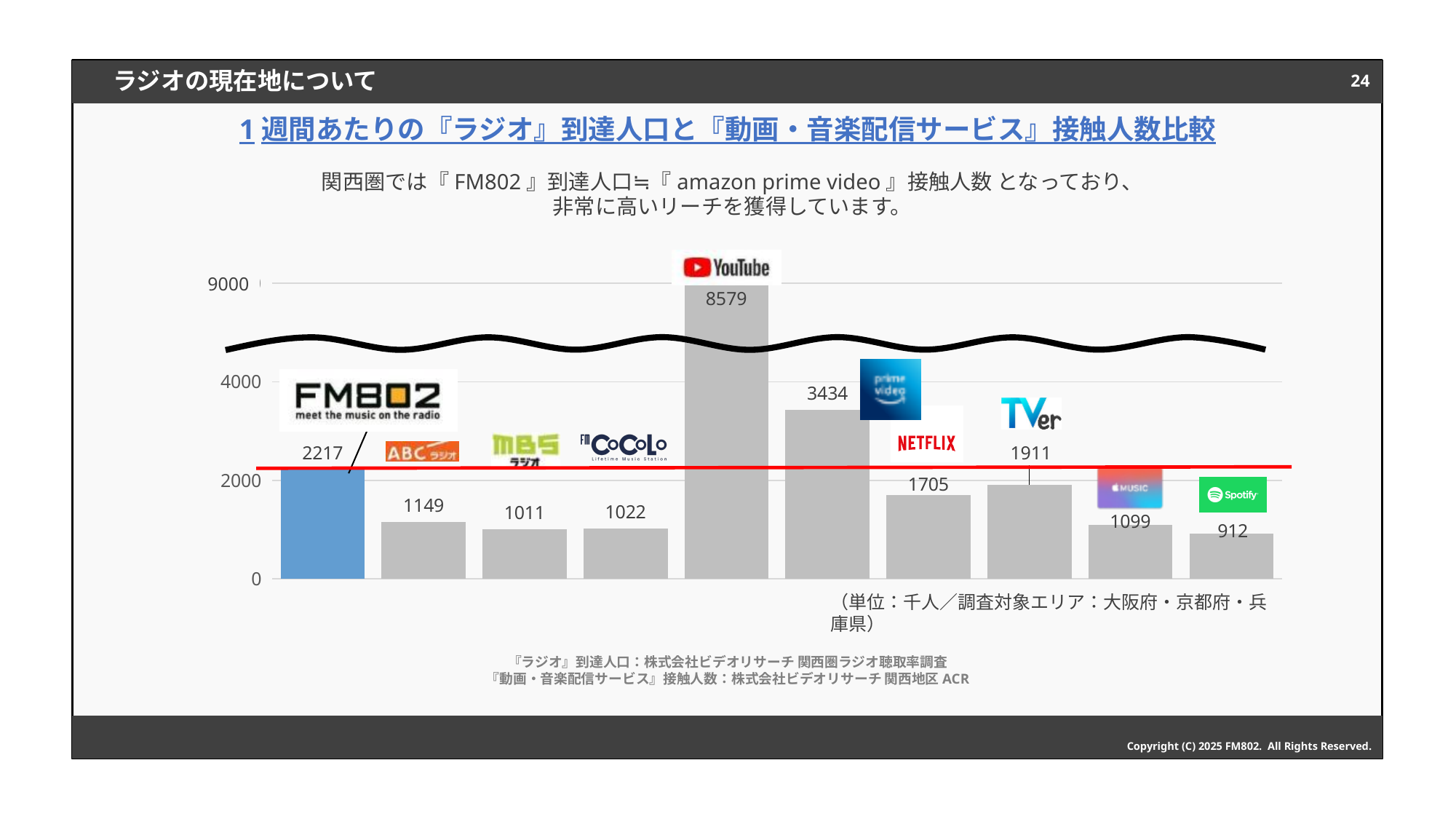
What is the value shown for FM802? 2217 What is the value shown for YouTube? 8579 Which is larger, the value for ABC ラジオ or the value for Apple Music? ABC ラジオ How many bars are plotted in the chart? 10 What is the value shown for prime video? 3434 Which category has the highest value? YouTube Which category has the lowest value? Spotify What kind of chart is shown on the slide? Bar chart What is the value shown for TVer? 1911 Which bar is coloured blue rather than grey? FM802 What is the difference between the values for FM802 and NETFLIX? 512 What is the value shown for Spotify? 912